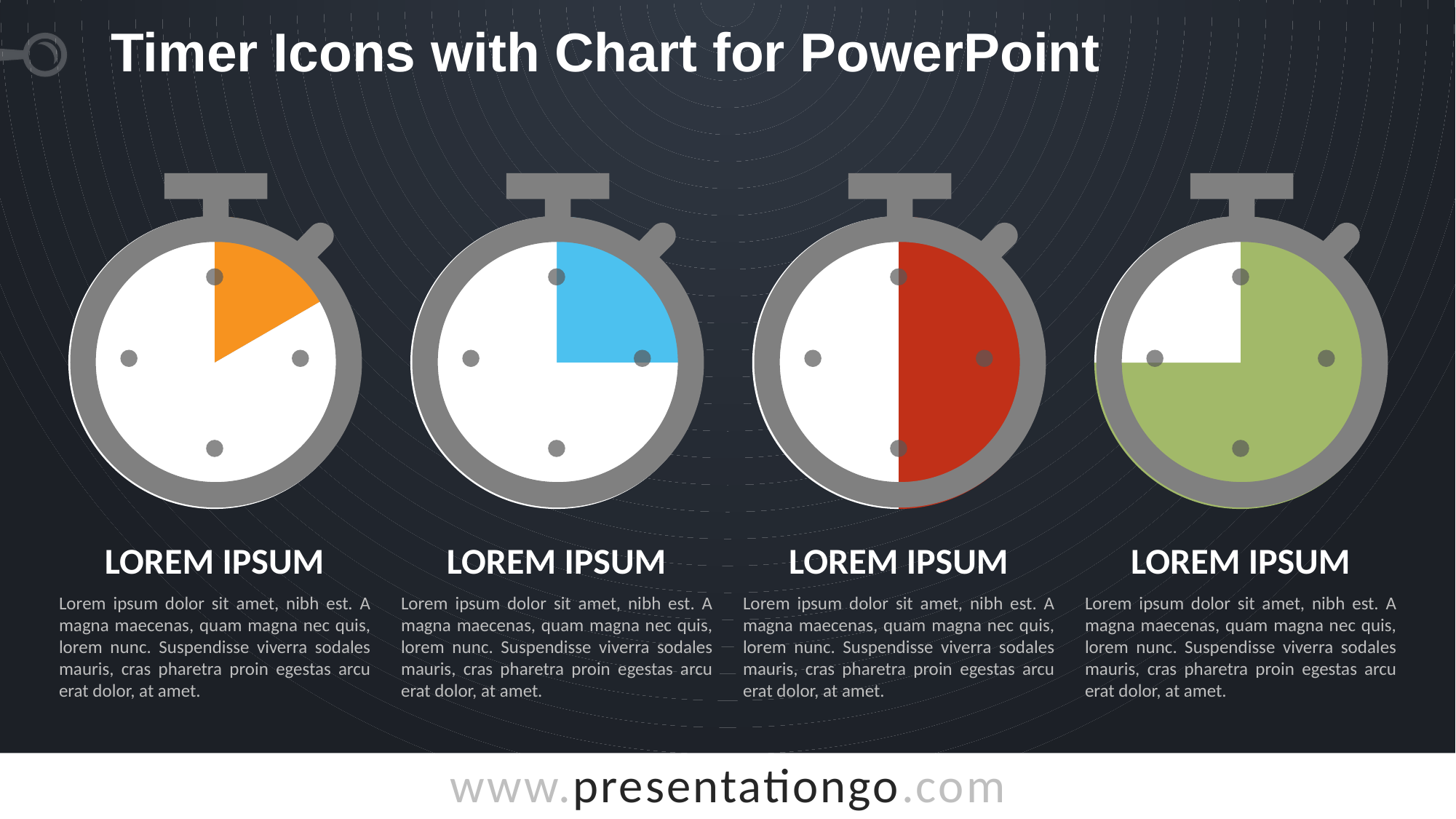
What colour is the filled portion of the first (leftmost) timer chart? orange Between the first and second timer charts, which has the larger filled portion? the second timer What colour is the filled portion of the third timer chart? red Between the second and third timer charts, which has the larger filled portion? the third timer Which timer chart has the largest filled portion? the fourth (rightmost) timer Which timer chart has the smallest filled portion? the first (leftmost) timer Between the third and fourth timer charts, which has the larger filled portion? the fourth timer How many timer charts are shown on the slide? 4 Do the filled portions of the timer charts increase or decrease from left to right across the slide? increase What kind of chart is drawn inside each timer icon on the slide? pie chart